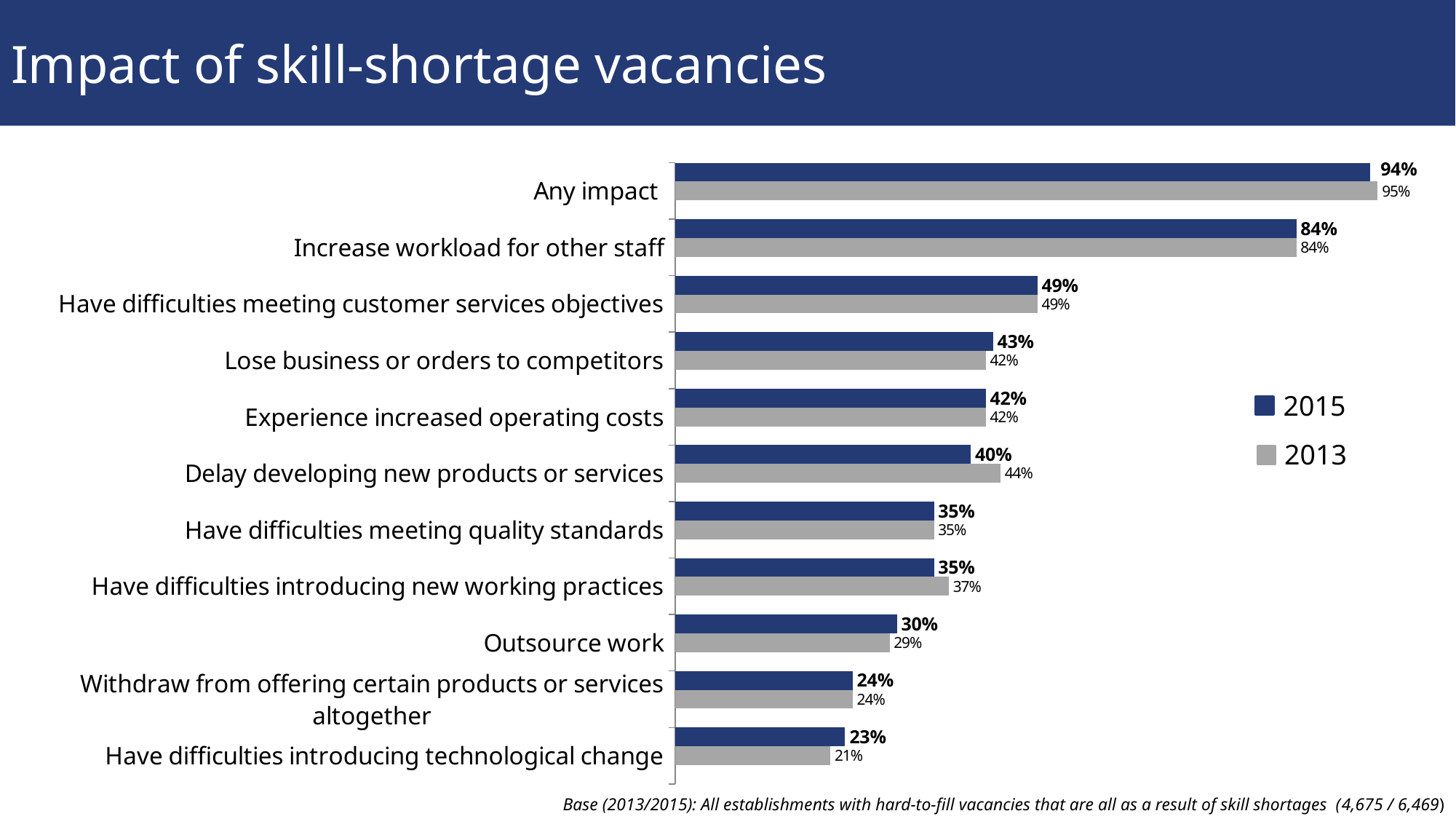
How many categories are shown on the chart? 11 What kind of chart is shown on the slide? Bar chart What is the 2015 value for 'Increase workload for other staff'? 84% What is the 2013 value for 'Have difficulties introducing technological change'? 21% For 'Have difficulties introducing new working practices', which year has the larger value, 2015 or 2013? 2013 Which category has the lowest 2013 value? Have difficulties introducing technological change What is the difference between the 2015 values for 'Any impact' and 'Increase workload for other staff'? 10 percentage points Which colour represents the 2013 series? Grey What is the 2013 value for 'Delay developing new products or services'? 44% What is the difference between the 2013 and 2015 values for 'Delay developing new products or services'? 4 percentage points How many series does the legend list? 2 Which category has the highest 2015 value? Any impact